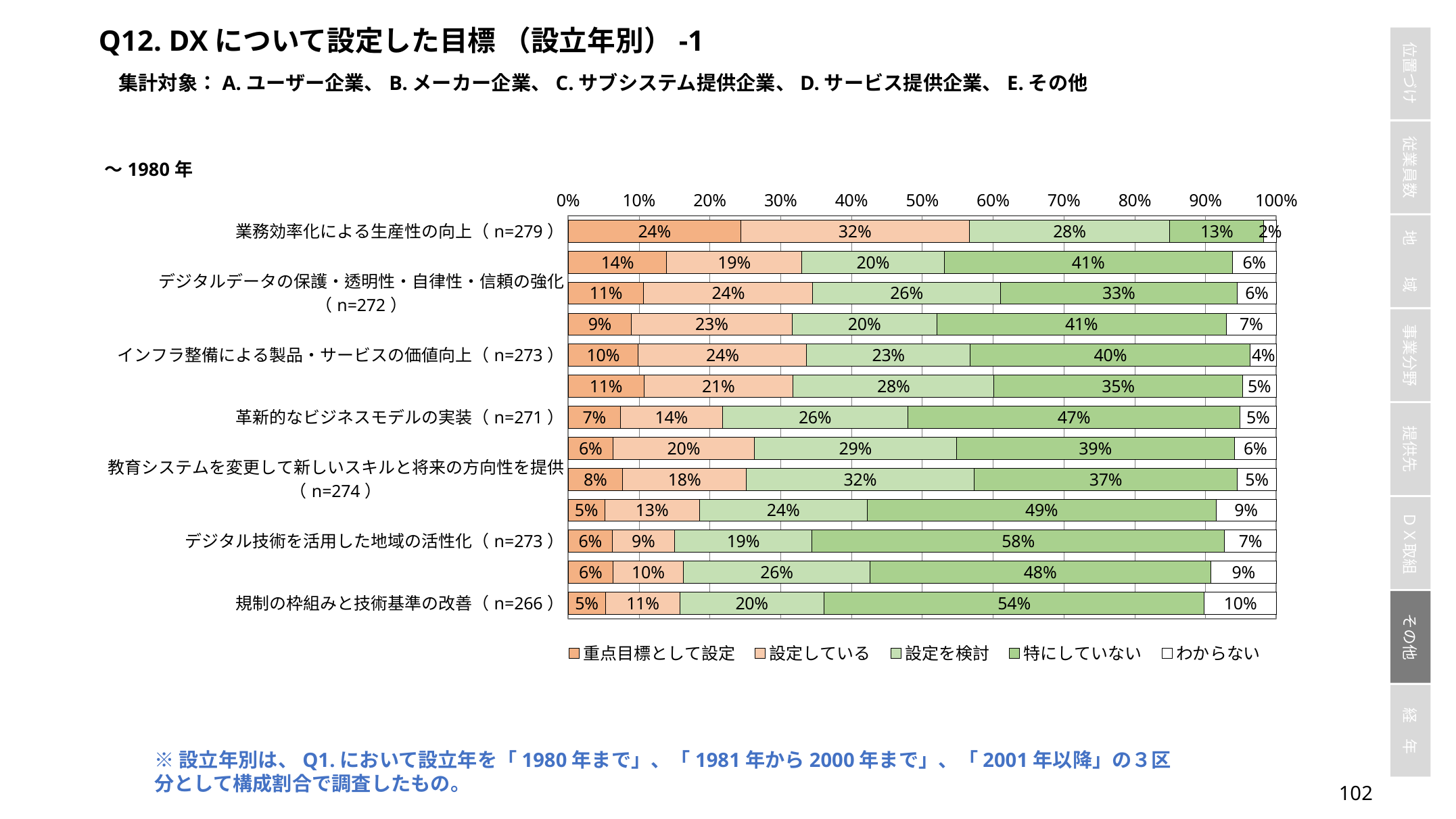
What is the 設定している value for インフラ整備による製品・サービスの価値向上 (n=273)? 24% How many series does the legend list? 5 Which category has the highest 重点目標として設定 value? 業務効率化による生産性の向上 (n=279) Which is larger: the 設定している value for 業務効率化による生産性の向上 (n=279) or for 革新的なビジネスモデルの実装 (n=271)? 業務効率化による生産性の向上 (n=279) What is the difference between the 特にしていない values for 規制の枠組みと技術基準の改善 (n=266) and 革新的なビジネスモデルの実装 (n=271)? 7% What is the わからない value for 規制の枠組みと技術基準の改善 (n=266)? 10% Which category has the highest 特にしていない value? デジタル技術を活用した地域の活性化 (n=273) What is the 特にしていない value for デジタル技術を活用した地域の活性化 (n=273)? 58% What kind of chart is shown on the slide? Stacked bar chart What is the total of the stacked bar for 規制の枠組みと技術基準の改善 (n=266)? 100% What is the 設定を検討 value for 革新的なビジネスモデルの実装 (n=271)? 26% What is the 重点目標として設定 value for 業務効率化による生産性の向上 (n=279)? 24%